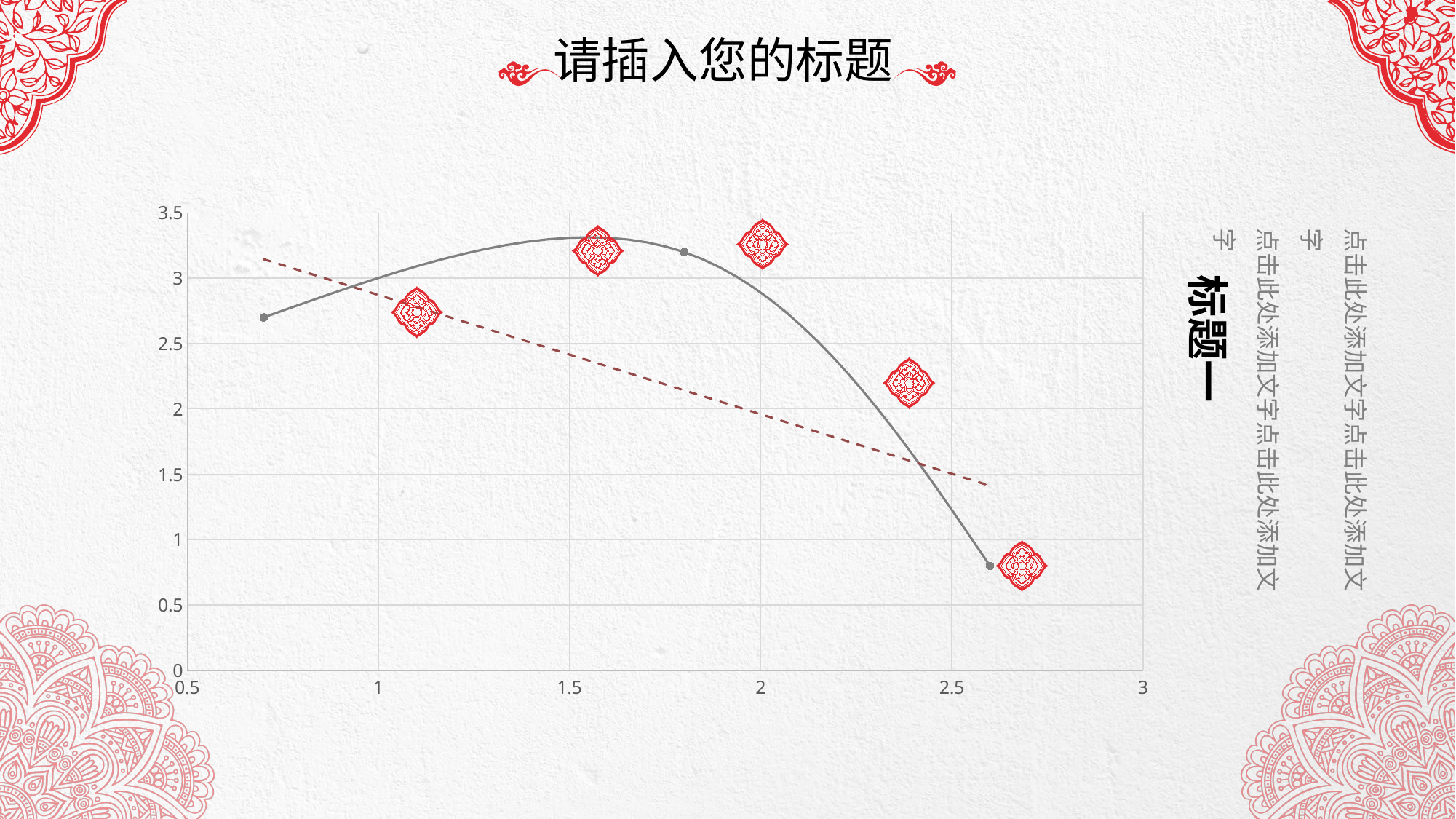
Which point has the lowest y value: the one near x = 1.1 or the one near x = 2.7? the one near x = 2.7 Is the value of the point near x = 1.1 greater or less than 2.5? greater Does the solid curve rise or fall between x = 2 and x = 2.5? fall Is the value of the point near x = 2.4 greater or less than 2.5? less What kind of chart is shown on the slide? scatter chart Does the dashed trend line rise or fall as x increases? fall What is the lowest value shown on the x axis? 0.5 Is the value of the point near x = 1.6 greater or less than 3? greater What is the highest value shown on the y axis? 3.5